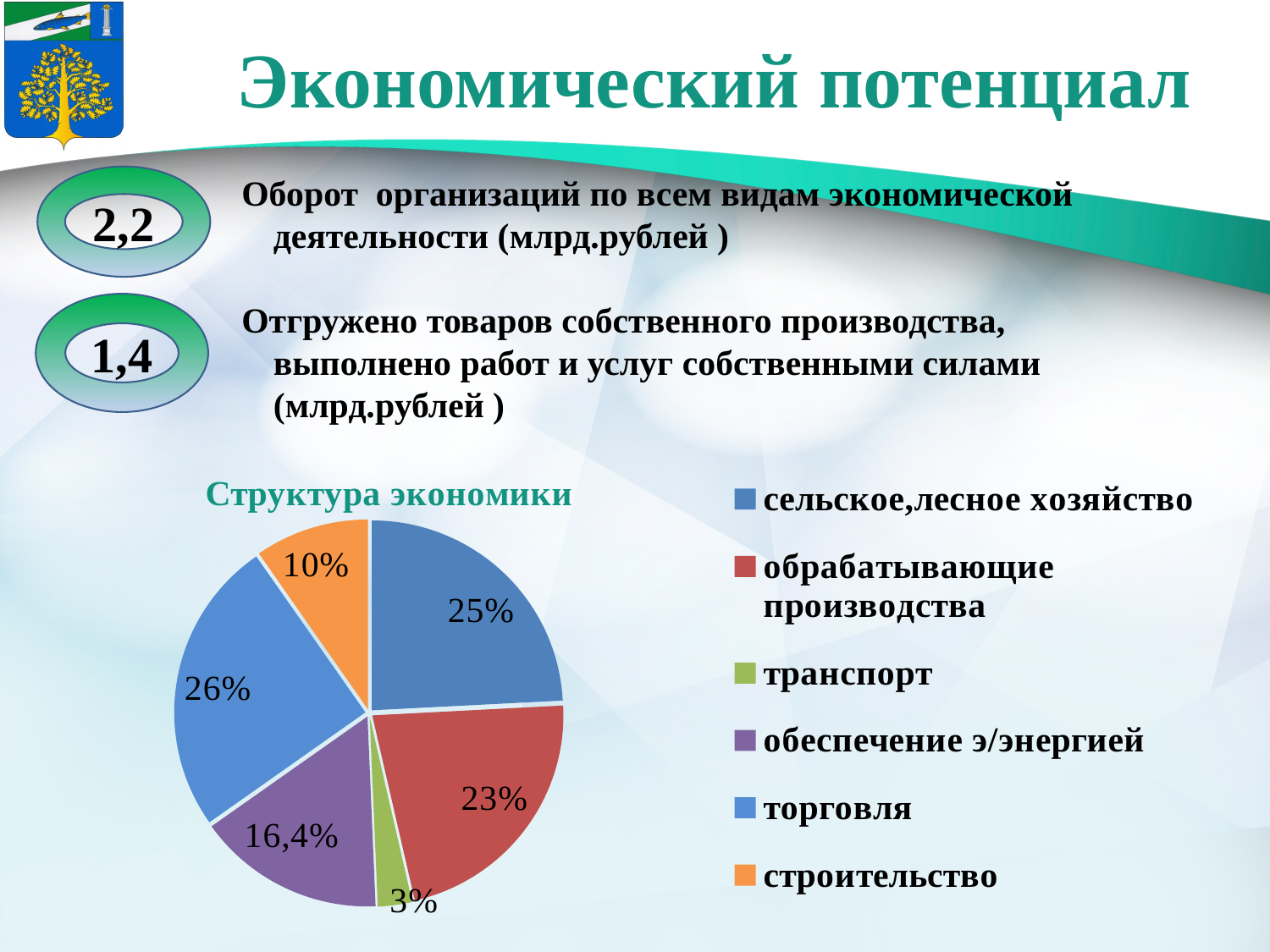
Which category has the smallest share of the pie chart? транспорт Which has a larger share, сельское,лесное хозяйство or обеспечение э/энергией? сельское,лесное хозяйство What share of the pie chart does торговля have? 26% What kind of chart is shown on the slide? pie chart What share of the pie chart does строительство have? 10% What is the difference between the shares of обрабатывающие производства and строительство? 13% What is the title of the pie chart? Структура экономики What share of the pie chart does обрабатывающие производства have? 23% What share of the pie chart does обеспечение э/энергией have? 16,4% Which category has the largest share of the pie chart? торговля What share of the pie chart does сельское,лесное хозяйство have? 25% How many categories does the pie chart show? 6